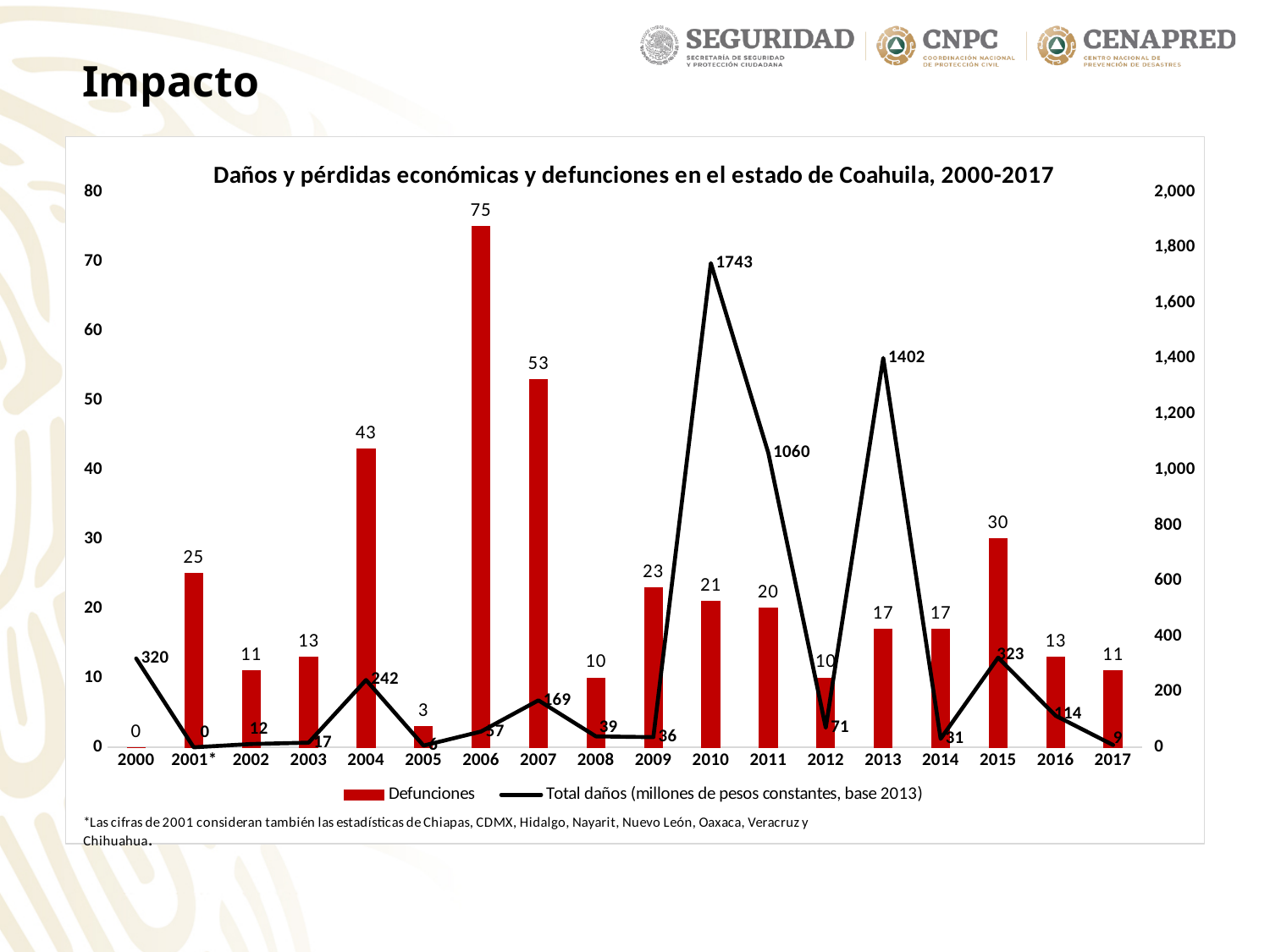
What is the title of the chart? Daños y pérdidas económicas y defunciones en el estado de Coahuila, 2000-2017 Is the Total daños value for 2011 greater or less than 1,000? greater What is the Total daños value for 2010? 1743 Which year has more Defunciones, 2004 or 2015? 2004 What is the difference in Defunciones between 2006 and 2007? 22 What is the difference in Total daños between 2010 and 2013? 341 How many years are shown on the x axis? 18 What kind of chart is used to show Defunciones? Bar chart How many series does the legend list? 2 Which year has the highest number of Defunciones? 2006 Which year has the highest Total daños value? 2010 How many deaths (Defunciones) are shown for 2006? 75